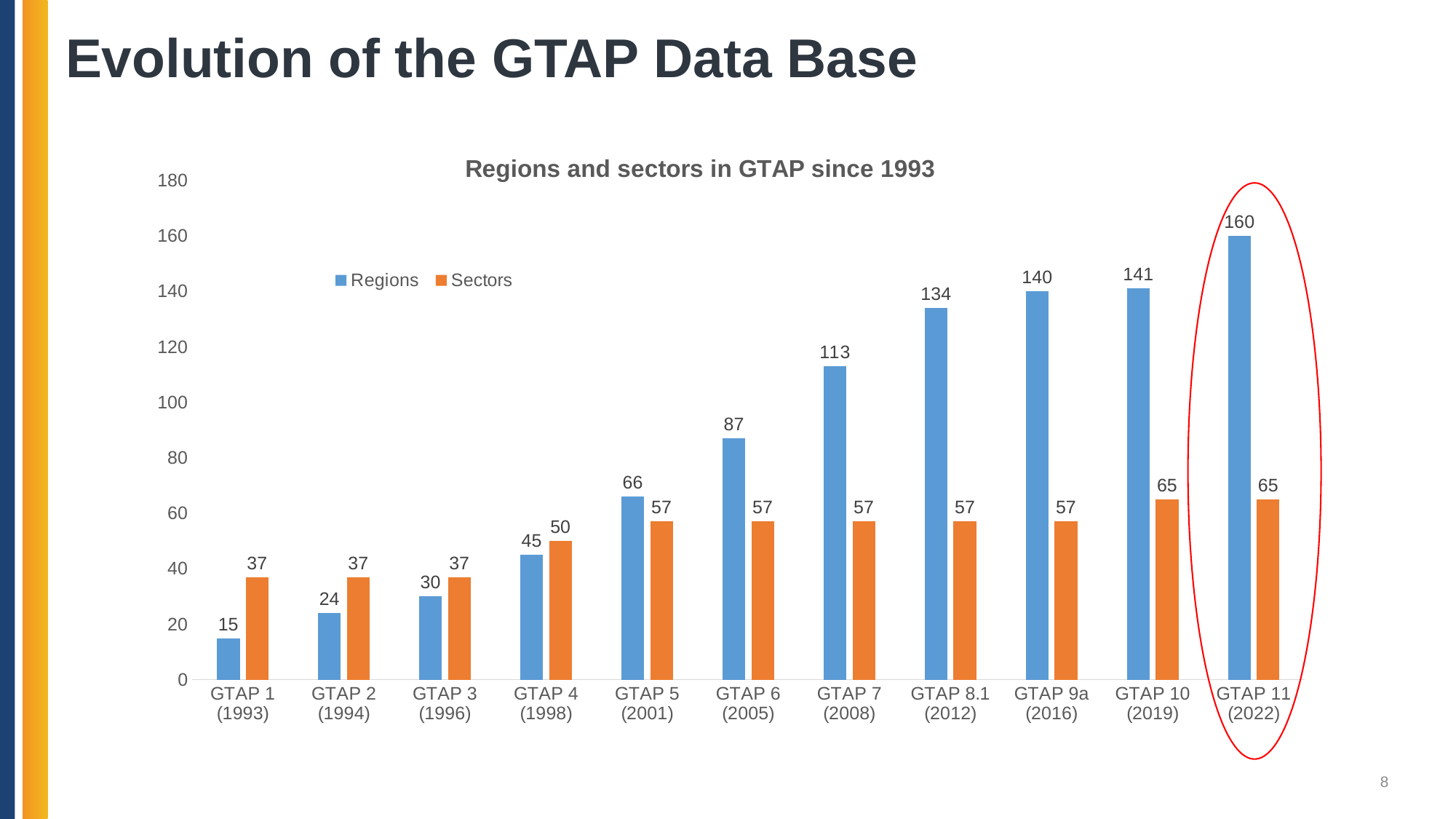
How many series does the legend list? 2 Which GTAP version has the highest number of Regions? GTAP 11 (2022) What kind of chart is shown on the slide? Bar chart For GTAP 4 (1998), which is larger, Regions or Sectors? Sectors What is the number of Regions for GTAP 11 (2022)? 160 What is the difference in Regions between GTAP 11 (2022) and GTAP 10 (2019)? 19 Do the Regions values rise or fall from GTAP 1 to GTAP 11? Rise What is the number of Sectors for GTAP 4 (1998)? 50 What is the number of Regions for GTAP 7 (2008)? 113 What is the difference between Regions and Sectors for GTAP 1 (1993)? 22 How many GTAP versions are shown on the x axis? 11 Which GTAP version has the lowest number of Regions? GTAP 1 (1993)